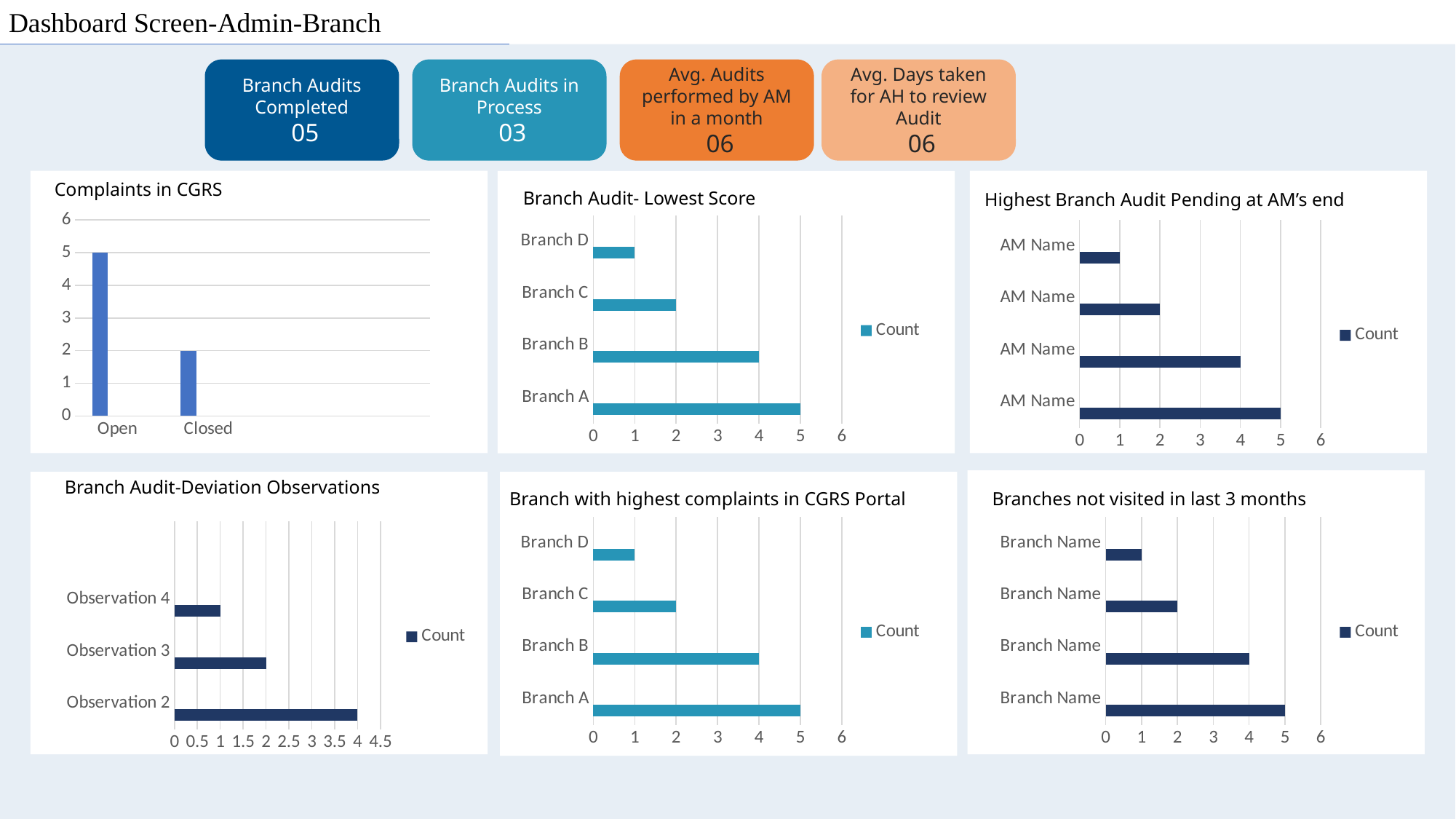
In the 'Branch Audit- Lowest Score' chart, what is the value for Branch B? 4 How many series does the legend of the 'Highest Branch Audit Pending at AM's end' chart list? 1 In the 'Branch Audit-Deviation Observations' chart, what is the value for Observation 2? 4 In the 'Branch Audit- Lowest Score' chart, how many branches are plotted? 4 In the 'Complaints in CGRS' chart, what is the value for Closed? 2 What kind of chart is 'Branches not visited in last 3 months'? Bar chart In the 'Complaints in CGRS' chart, what is the value for Open? 5 In the 'Branch Audit-Deviation Observations' chart, which observation has the highest value? Observation 2 In the 'Complaints in CGRS' chart, what is the difference between Open and Closed? 3 In the 'Branch Audit- Lowest Score' chart, which branch has the lowest value? Branch D In the 'Branch with highest complaints in CGRS Portal' chart, which is larger, Branch C or Branch D? Branch C In the 'Branch with highest complaints in CGRS Portal' chart, what is the value for Branch A? 5